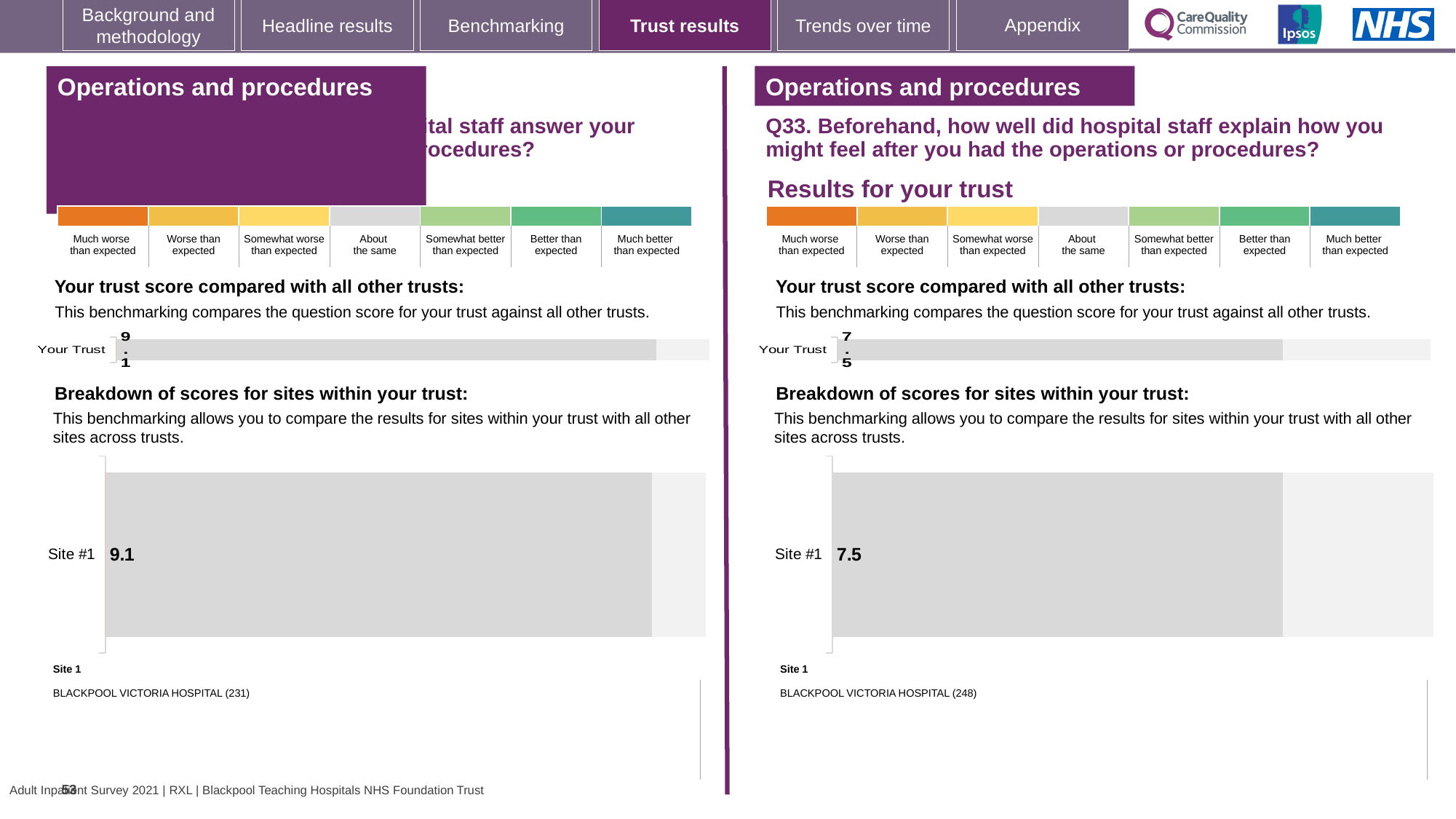
Which hospital is listed as Site 1 beneath the left-hand breakdown chart? BLACKPOOL VICTORIA HOSPITAL (231) What is the difference between the Site #1 score in the left-hand breakdown chart and the Site #1 score in the right-hand breakdown chart? 1.6 How many sites are plotted in the right-hand 'Breakdown of scores for sites within your trust' chart? 1 On the right half of the slide (Q33), what is the value shown for Your Trust in the 'Your trust score compared with all other trusts' chart? 7.5 Which is larger: the Your Trust score in the left-hand chart or the Your Trust score in the right-hand chart? The left-hand chart (9.1) What kind of chart is used to show the Site #1 score on the right half of the slide? Bar chart Which hospital is listed as Site 1 beneath the right-hand breakdown chart? BLACKPOOL VICTORIA HOSPITAL (248) In the left-hand 'Breakdown of scores for sites within your trust' chart, what is the value for Site #1? 9.1 What kind of chart is used to show the Your Trust score on the left half of the slide? Bar chart In the right-hand 'Breakdown of scores for sites within your trust' chart, what is the value for Site #1? 7.5 On the left half of the slide, what is the value shown for Your Trust in the 'Your trust score compared with all other trusts' chart? 9.1 How many sites are plotted in the left-hand 'Breakdown of scores for sites within your trust' chart? 1